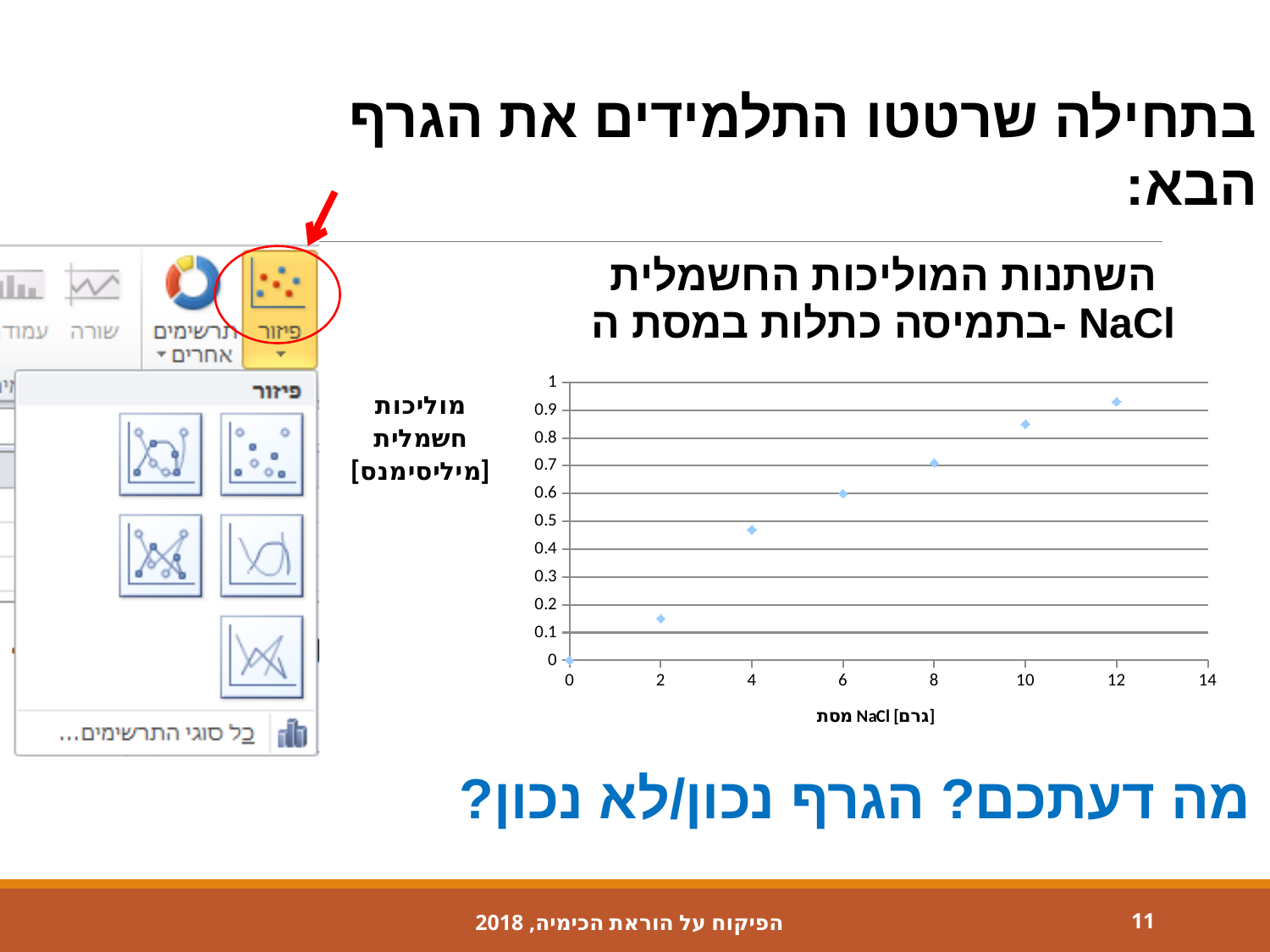
Is the conductivity value at NaCl mass 8 greater or less than 0.8? less Is the conductivity value at NaCl mass 4 greater or less than 0.4? greater Do the plotted values rise or fall as the NaCl mass increases along the x axis? rise What is the label of the x axis of the chart? מסת NaCl [גרם] What kind of chart is shown on the slide? scatter chart Is the conductivity value at NaCl mass 2 greater or less than 0.2? less At which NaCl mass is the plotted conductivity lowest? 0 At which NaCl mass is the plotted conductivity highest? 12 Which has the larger conductivity value: NaCl mass 4 or NaCl mass 10? 10 How many data points are plotted in the chart? 7 What is the label of the y axis of the chart? מוליכות חשמלית [מיליסימנס]